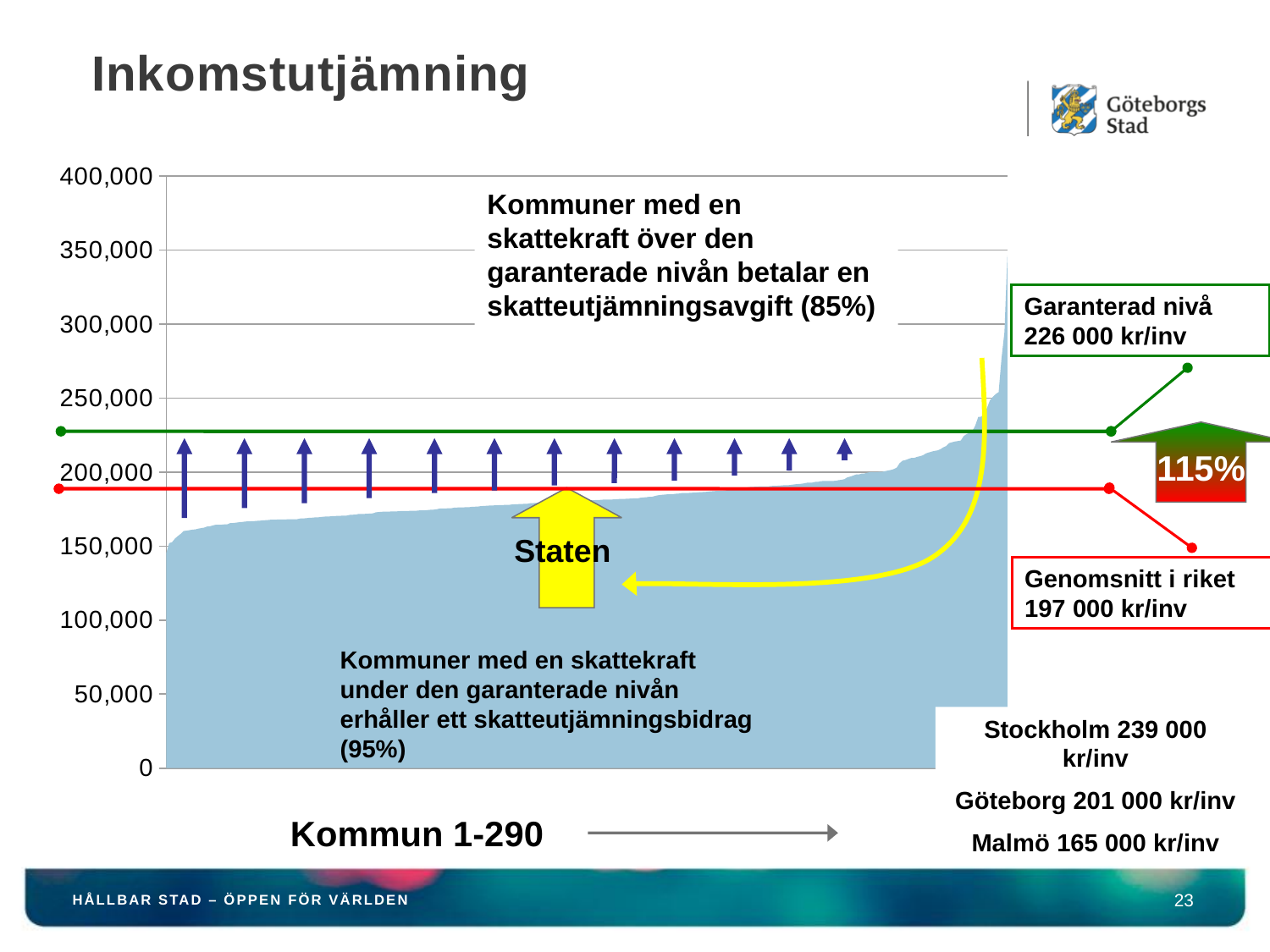
What value is given for Stockholm on the chart? 239 000 kr/inv What is the difference between the values given for Stockholm and Malmö? 74 000 kr/inv What value is given for Göteborg on the chart? 201 000 kr/inv What kind of chart is shown on the slide? Area chart What is the difference between the 'Garanterad nivå' and 'Genomsnitt i riket' values? 29 000 kr/inv What is the value of the 'Garanterad nivå' marked on the chart? 226 000 kr/inv How many municipalities does the x axis label indicate are plotted? 290 What value is given for Malmö on the chart? 165 000 kr/inv Which has the higher value on the chart, Stockholm or Göteborg? Stockholm What is the value of 'Genomsnitt i riket' marked on the chart? 197 000 kr/inv What is the title of the slide containing the chart? Inkomstutjämning Do the plotted values rise or fall from left to right along the x axis (Kommun 1-290)? Rise